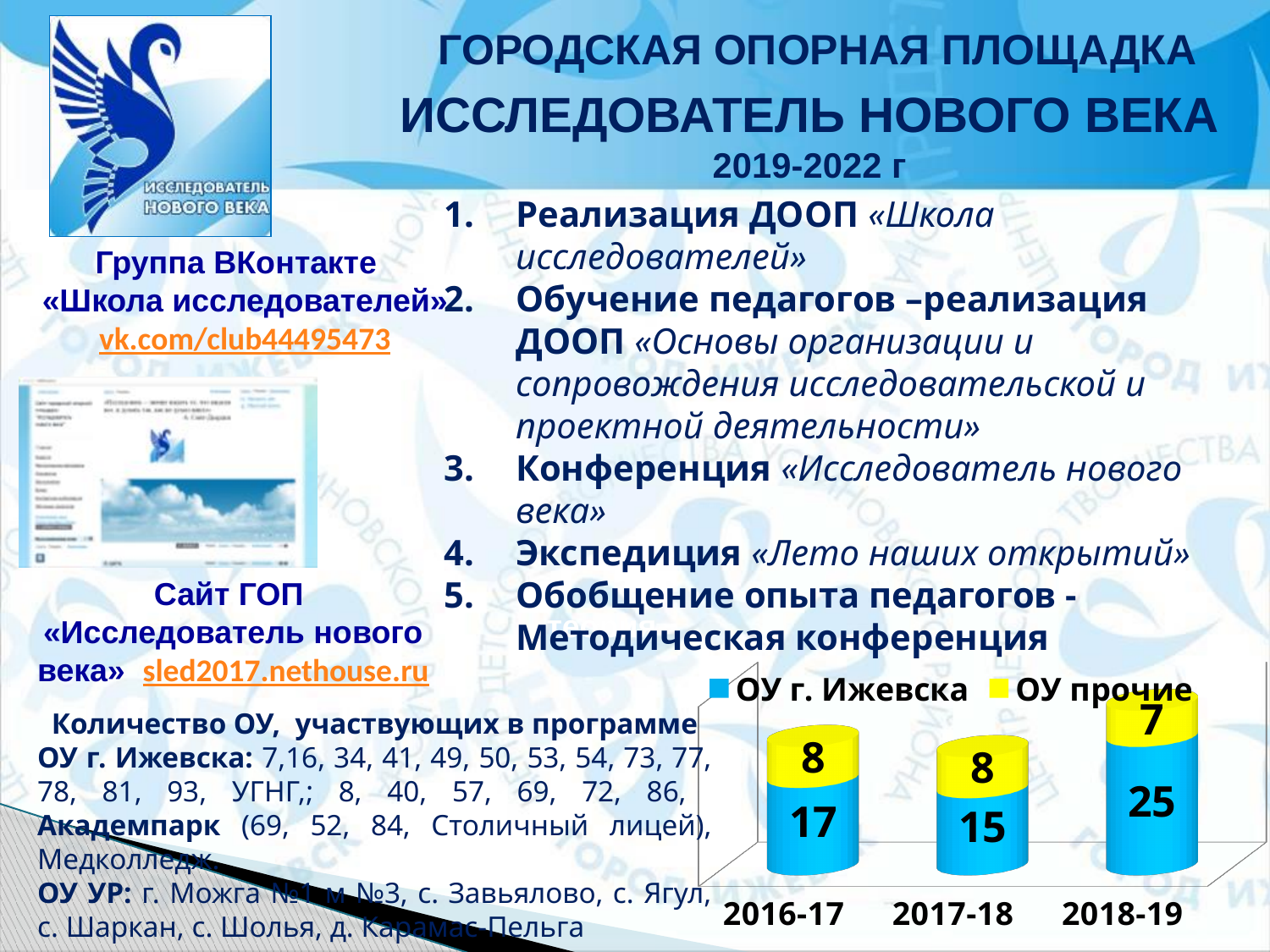
Which year has the lowest value for ОУ г. Ижевска? 2017-18 What is the difference between the ОУ г. Ижевска values for 2018-19 and 2017-18? 10 What is the total of the stacked bar for 2016-17? 25 What kind of chart is shown on the slide? Stacked bar chart Which is larger: ОУ г. Ижевска in 2016-17 or ОУ г. Ижевска in 2017-18? 2016-17 What value is shown for ОУ прочие in 2018-19? 7 How many series does the chart legend list? 2 What is the total of the stacked bar for 2018-19? 32 How many categories (years) are shown on the x axis of the chart? 3 What value is shown for ОУ г. Ижевска in 2016-17? 17 What value is shown for ОУ г. Ижевска in 2017-18? 15 Which year has the highest value for ОУ г. Ижевска? 2018-19